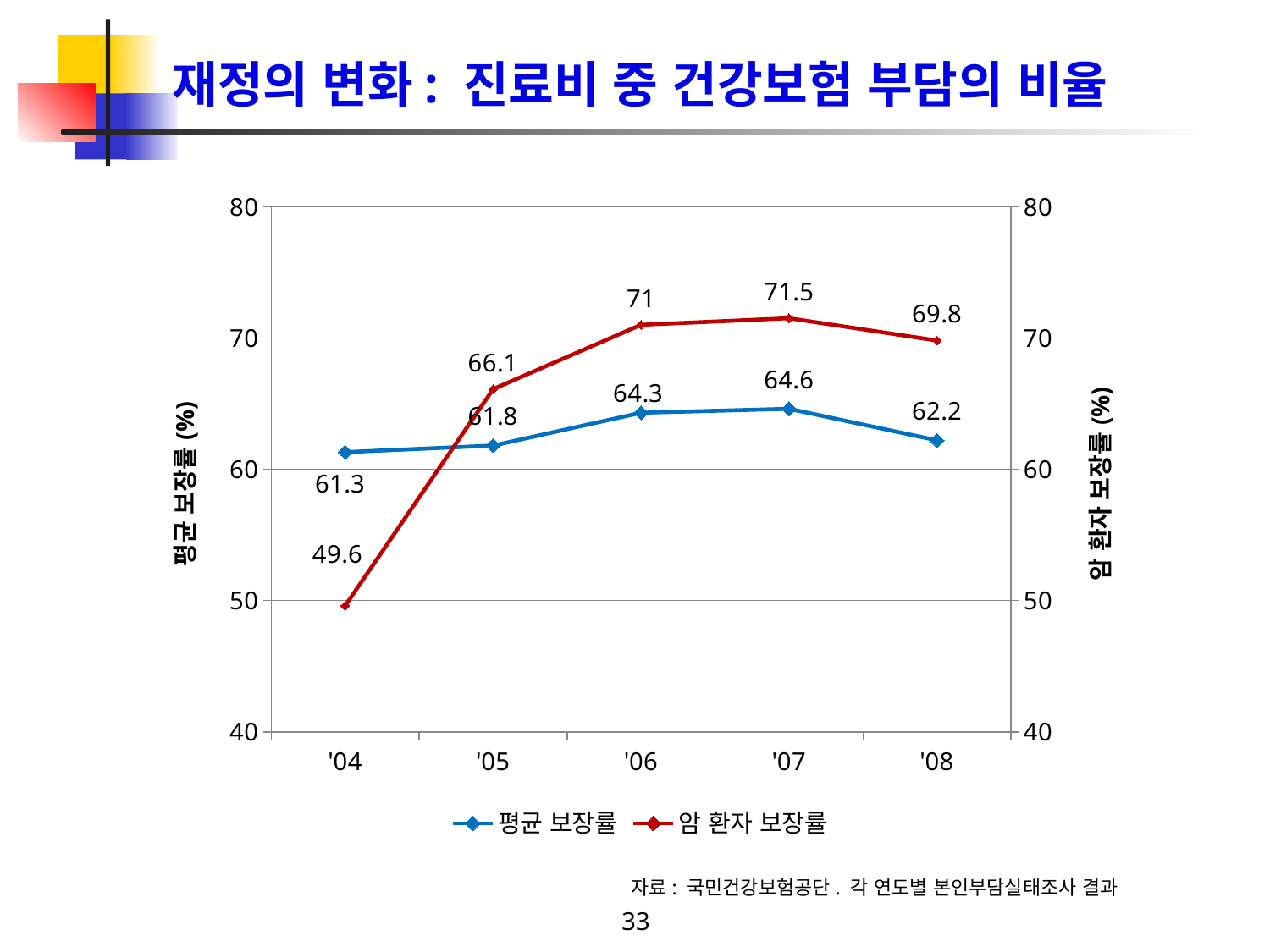
In which year is 평균 보장률 lowest? '04 How many series does the legend list? 2 What kind of chart is shown on the slide? Line chart Which is larger in '04: 평균 보장률 or 암 환자 보장률? 평균 보장률 What is the value of 암 환자 보장률 in '05? 66.1 How many years are shown on the x axis? 5 Does 암 환자 보장률 rise or fall from '04 to '07? Rise What colour is the line for 암 환자 보장률? Red What is the value of 평균 보장률 in '04? 61.3 What is the value of 암 환자 보장률 in '08? 69.8 What is the difference between 암 환자 보장률 and 평균 보장률 in '07? 6.9 In which year is 암 환자 보장률 highest? '07